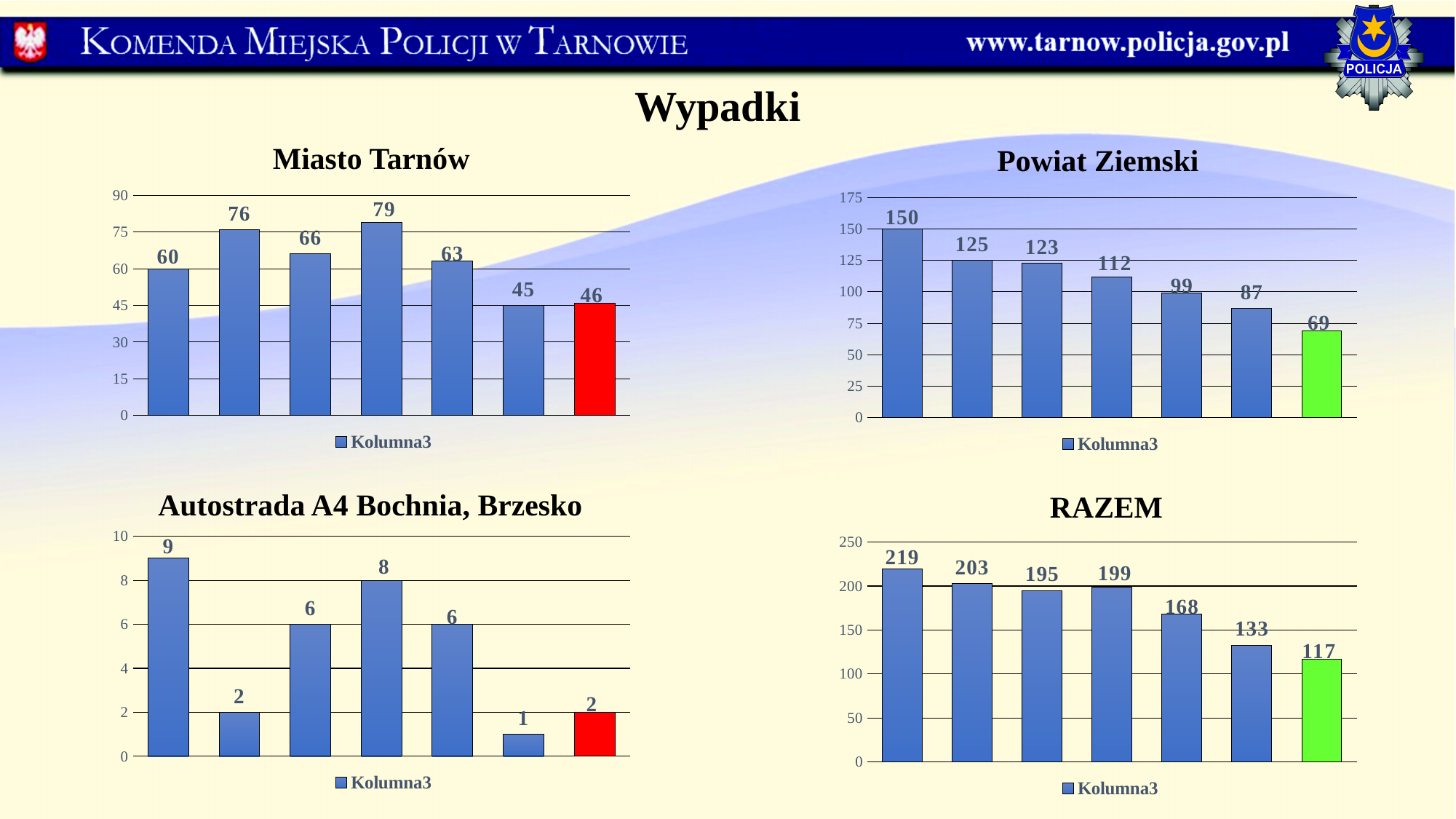
In the "RAZEM" chart, what is the value of the green bar (the last bar)? 117 In the "Autostrada A4 Bochnia, Brzesko" chart, what is the value of the first bar? 9 In the "Powiat Ziemski" chart, what is the value of the first bar? 150 How many series does the legend of the "Miasto Tarnów" chart list? 1 In the "Powiat Ziemski" chart, what is the difference between the first bar (150) and the green bar (69)? 81 In the "RAZEM" chart, which is larger: the third bar (195) or the fourth bar (199)? 199 In the "Powiat Ziemski" chart, do the values generally rise or fall from left to right? fall What kind of chart is the "RAZEM" chart? bar chart In the "Miasto Tarnów" chart, what is the value of the red bar (the last bar)? 46 How many bars are in the "Autostrada A4 Bochnia, Brzesko" chart? 7 In the "Miasto Tarnów" chart, what is the lowest value shown? 45 In the "Miasto Tarnów" chart, what is the highest value shown? 79